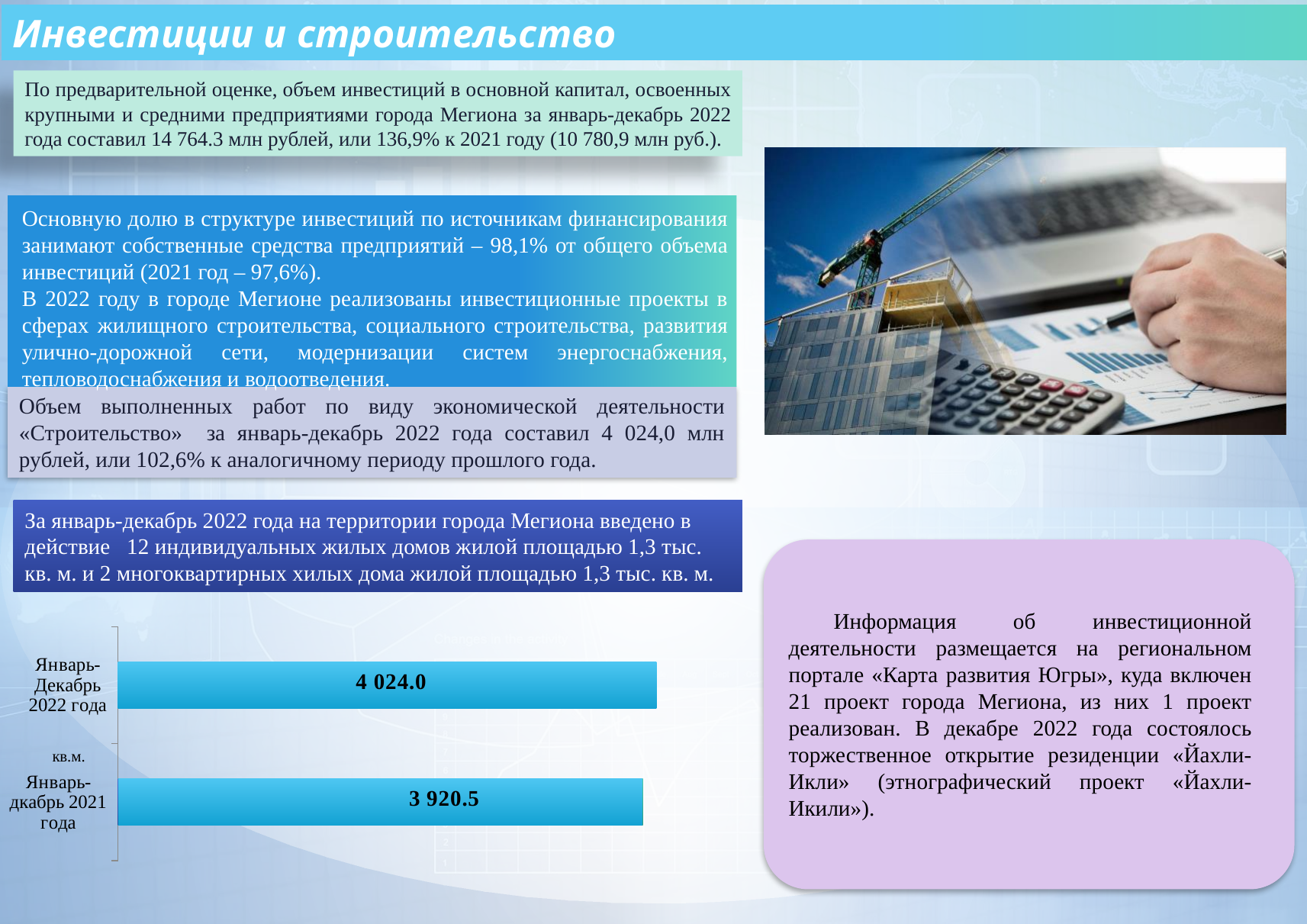
What type of chart is shown at the bottom left of the slide? bar chart What is the difference between the values for Январь-Декабрь 2022 года and Январь-дкабрь 2021 года in the bar chart? 103.5 In the bar chart, which is larger: the value for Январь-Декабрь 2022 года or for Январь-дкабрь 2021 года? Январь-Декабрь 2022 года What is the value for Январь-Декабрь 2022 года in the bar chart? 4 024.0 Are the bars in the chart oriented horizontally or vertically? horizontally Which category has the lowest value in the bar chart? Январь-дкабрь 2021 года How many categories are shown in the bar chart? 2 What colour are the bars in the chart? blue What is the value for Январь-дкабрь 2021 года in the bar chart? 3 920.5 Which category has the highest value in the bar chart? Январь-Декабрь 2022 года